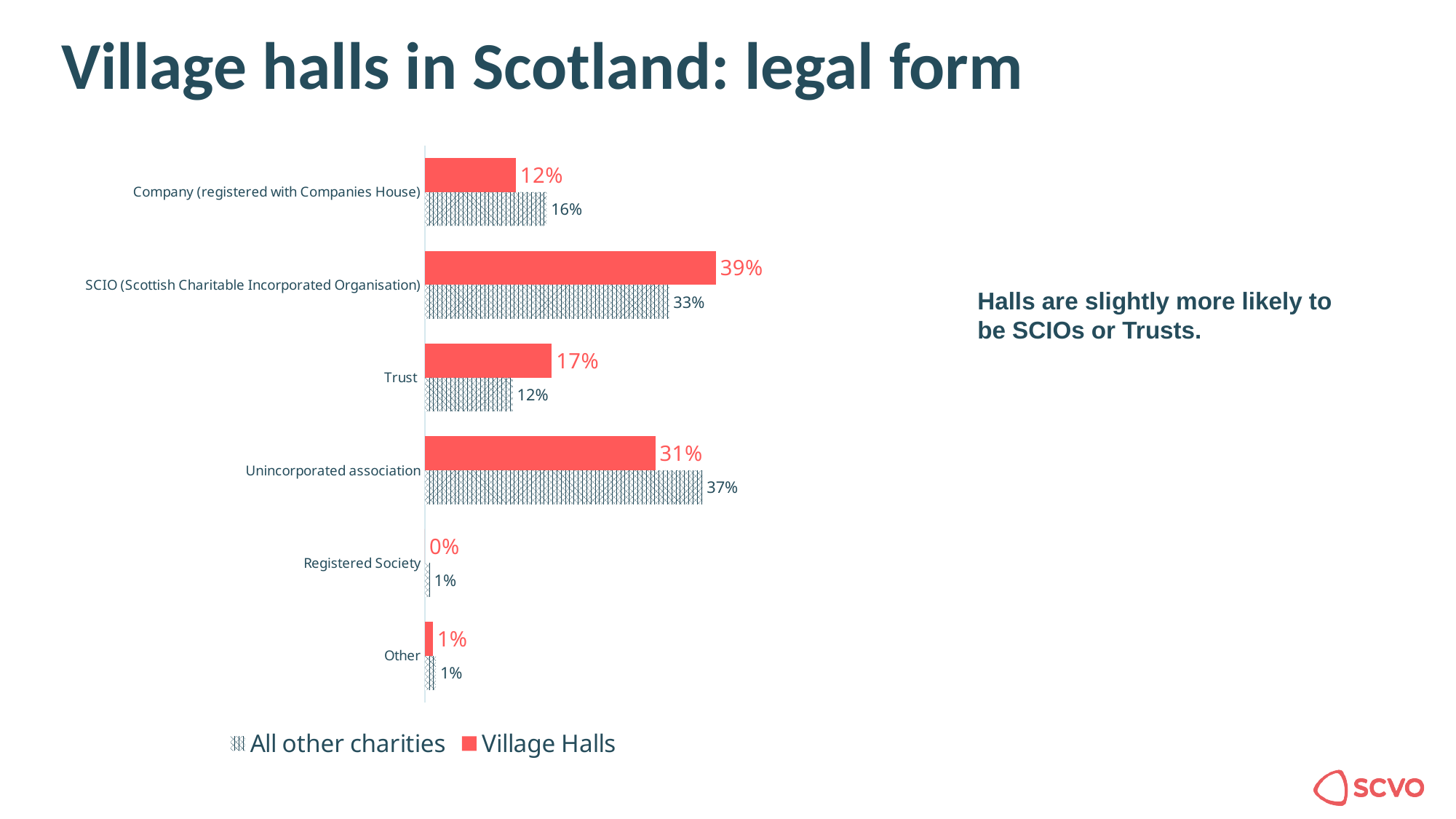
For Trust, which series has the larger value: Village Halls or All other charities? Village Halls Which series is shown with solid red bars? Village Halls What percentage of All other charities are Unincorporated associations? 37% What percentage of Village Halls are SCIOs (Scottish Charitable Incorporated Organisations)? 39% How many series does the legend list? 2 Which legal form has the highest percentage for Village Halls? SCIO (Scottish Charitable Incorporated Organisation) Which legal form has the lowest percentage for Village Halls? Registered Society How many legal form categories are shown on the chart? 6 What percentage of Village Halls are Trusts? 17% What percentage of All other charities are Companies (registered with Companies House)? 16% What kind of chart is shown on the slide? Bar chart What is the difference between the Village Halls and All other charities percentages for Unincorporated association? 6%